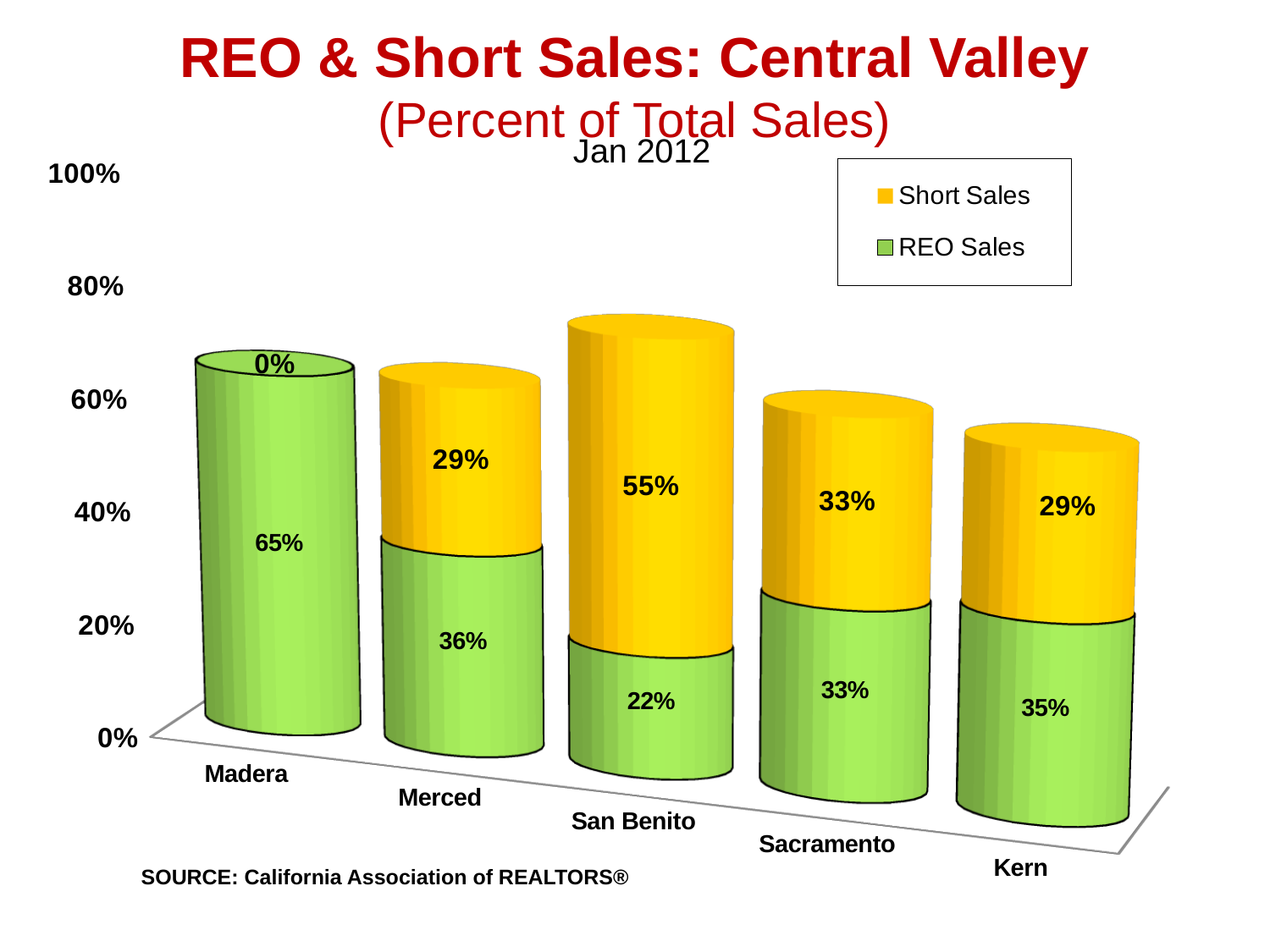
What is the Short Sales value for Madera? 0% What is the difference between the Short Sales value for San Benito and the Short Sales value for Merced? 26% What is the Short Sales value for San Benito? 55% Which is larger, the REO Sales value for Merced or the REO Sales value for Sacramento? Merced How many counties are shown on the x axis? 5 What is the combined total of REO Sales and Short Sales for San Benito? 77% How many series does the legend list? 2 What is the REO Sales value for Madera? 65% What kind of chart is shown on the slide? Stacked bar chart Which county has the highest Short Sales percentage? San Benito What is the REO Sales value for Kern? 35% Which county has the lowest REO Sales percentage? San Benito